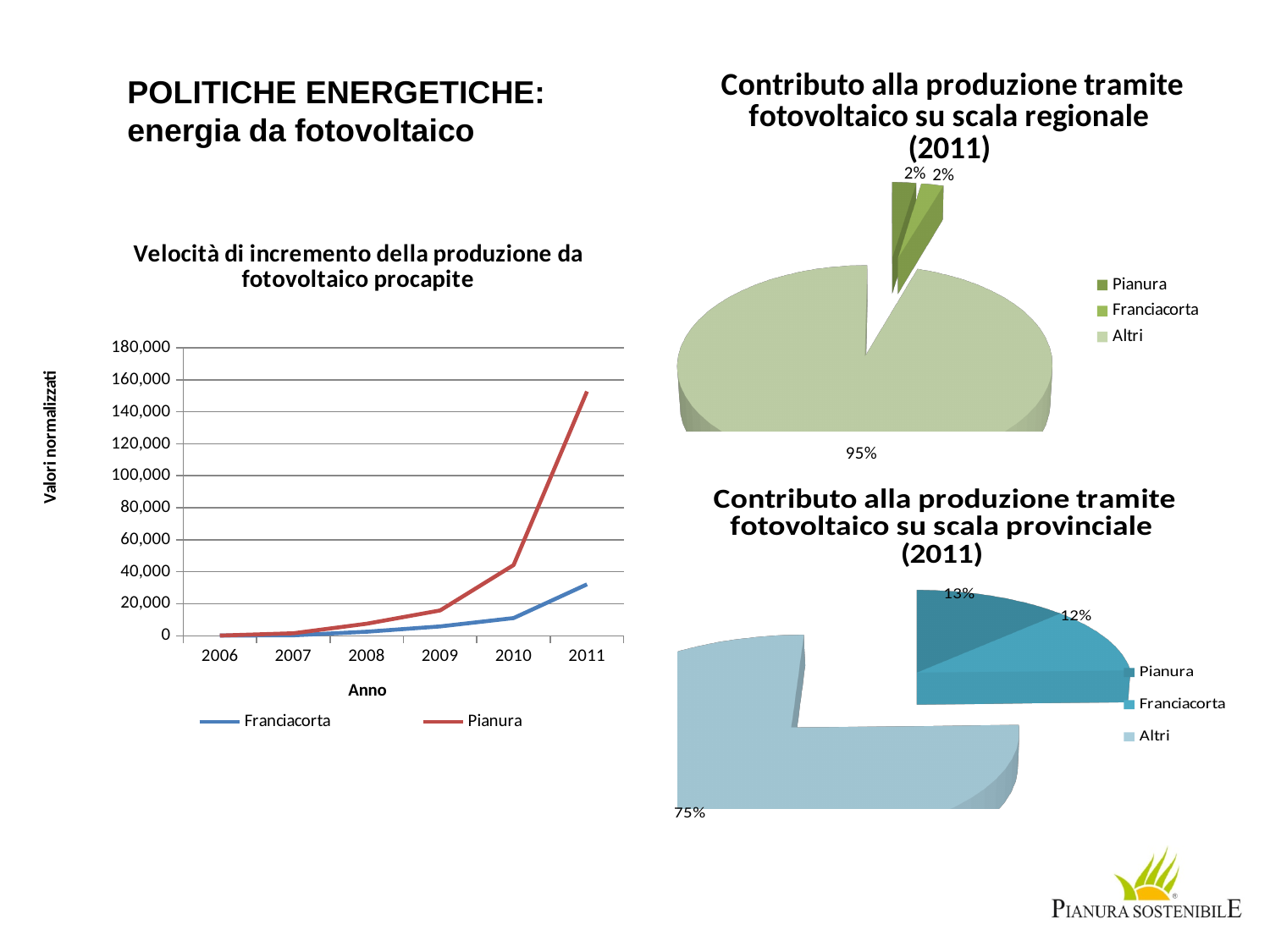
How many series does the legend of "Velocità di incremento della produzione da fotovoltaico procapite" list? 2 What kind of chart is "Velocità di incremento della produzione da fotovoltaico procapite"? line chart In the pie chart "Contributo alla produzione tramite fotovoltaico su scala provinciale (2011)", what share does Franciacorta have? 12% In the pie chart "Contributo alla produzione tramite fotovoltaico su scala regionale (2011)", what share does Altri have? 95% In "Velocità di incremento della produzione da fotovoltaico procapite", which series is higher in 2011, Franciacorta or Pianura? Pianura In "Velocità di incremento della produzione da fotovoltaico procapite", is the value for Pianura in 2011 greater or less than 140,000? greater In the pie chart "Contributo alla produzione tramite fotovoltaico su scala provinciale (2011)", what is the difference between the shares of Altri and Pianura? 62 percentage points In "Velocità di incremento della produzione da fotovoltaico procapite", is the value for Franciacorta in 2011 greater or less than 40,000? less In the pie chart "Contributo alla produzione tramite fotovoltaico su scala regionale (2011)", what share does Pianura have? 2% In "Velocità di incremento della produzione da fotovoltaico procapite", do the values for Pianura rise or fall from 2006 to 2011? rise How many years are shown on the x axis of "Velocità di incremento della produzione da fotovoltaico procapite"? 6 In the pie chart "Contributo alla produzione tramite fotovoltaico su scala provinciale (2011)", which category has the largest share? Altri